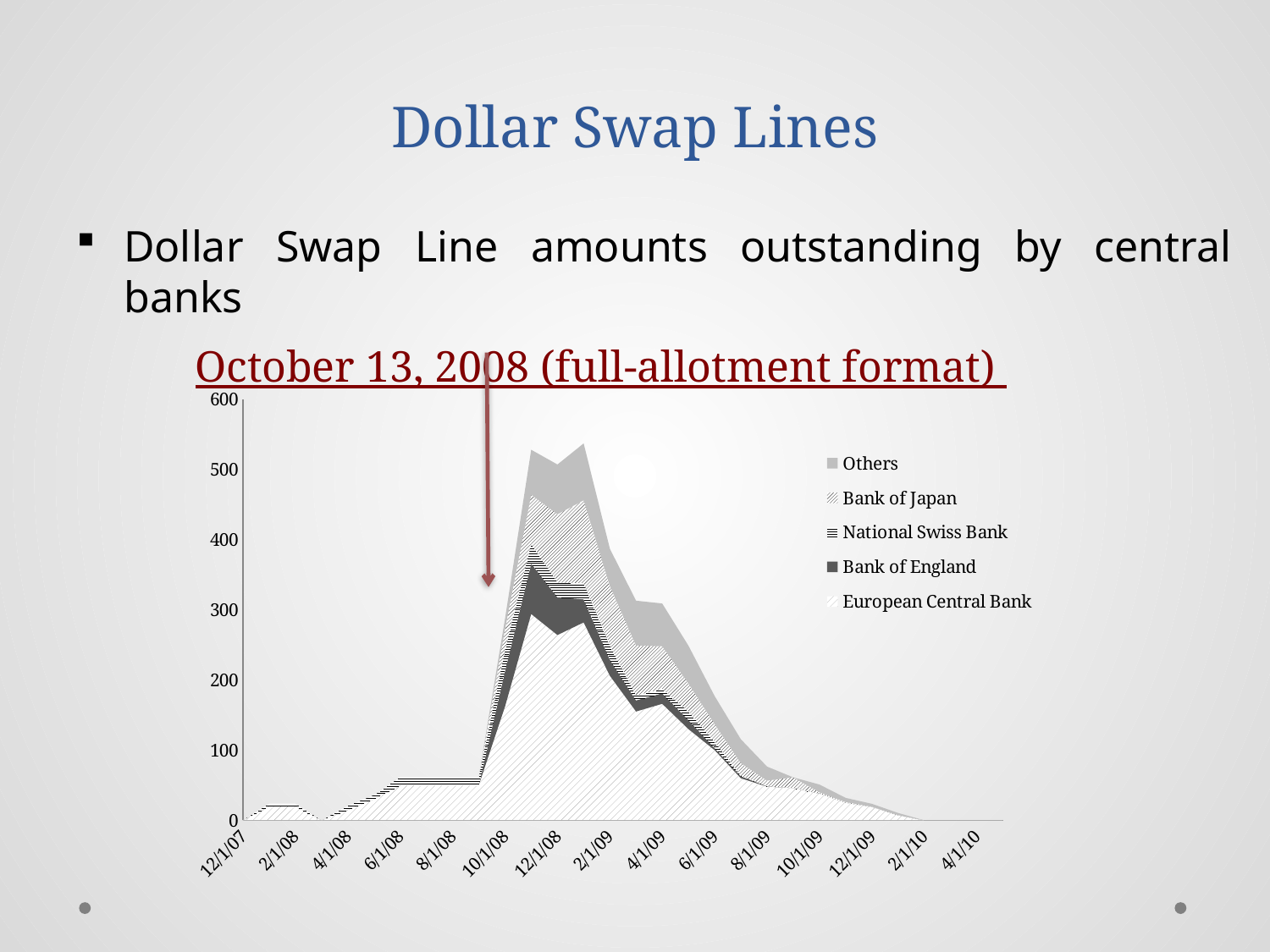
Which series forms the bottom layer of the stacked area chart? European Central Bank What kind of chart is shown on the slide? stacked area chart How many series does the legend list? 5 Do the total amounts outstanding rise or fall between 12/1/08 and 4/1/10? fall What is the highest value shown on the y axis? 600 Which series is listed first in the legend? Others Is the total amount outstanding at 8/1/08 greater or less than 100? less Do the total amounts outstanding rise or fall between 8/1/08 and 12/1/08? rise Which series accounts for the largest share of the total at the peak around 12/1/08? European Central Bank How many date labels are shown on the x axis? 15 Is the total amount outstanding at 2/1/10 greater or less than 100? less Is the total amount outstanding at its peak around 12/1/08 greater or less than 500? greater